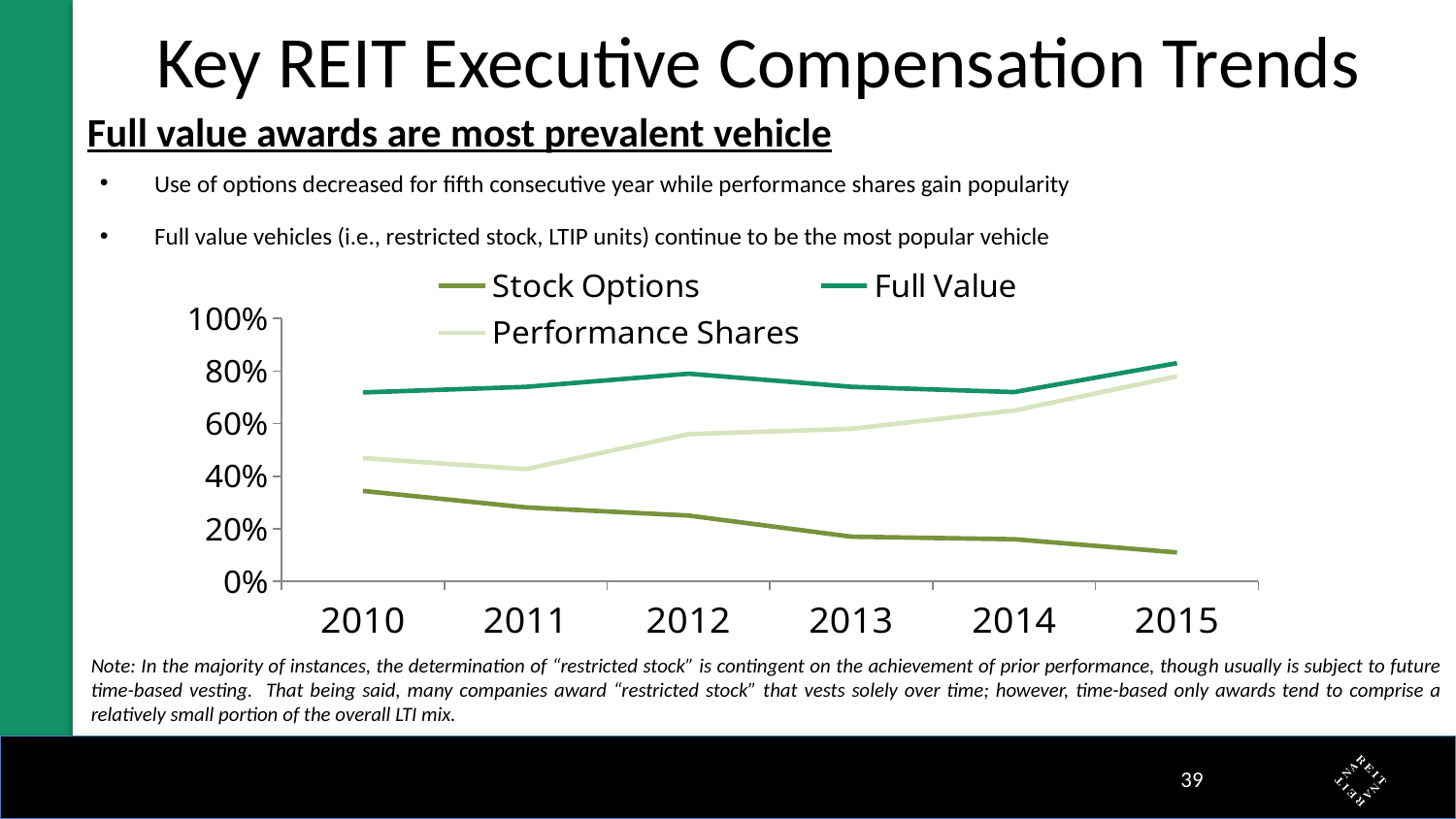
What kind of chart is shown on the slide? Line chart In 2010, which series has the larger value, Full Value or Performance Shares? Full Value In which year is the Stock Options value lowest? 2015 In which year is the Performance Shares value highest? 2015 How many years are shown along the x axis of the chart? 6 Is the Performance Shares value for 2015 greater or less than 60%? greater How many series does the chart's legend list? 3 Does the Performance Shares line rise or fall from 2011 to 2015? Rise Does the Stock Options line rise or fall from 2010 to 2015? Fall Is the Stock Options value for 2010 greater or less than 40%? less In which year is the Stock Options value highest? 2010 Which series is plotted with the darkest green line in the chart? Full Value